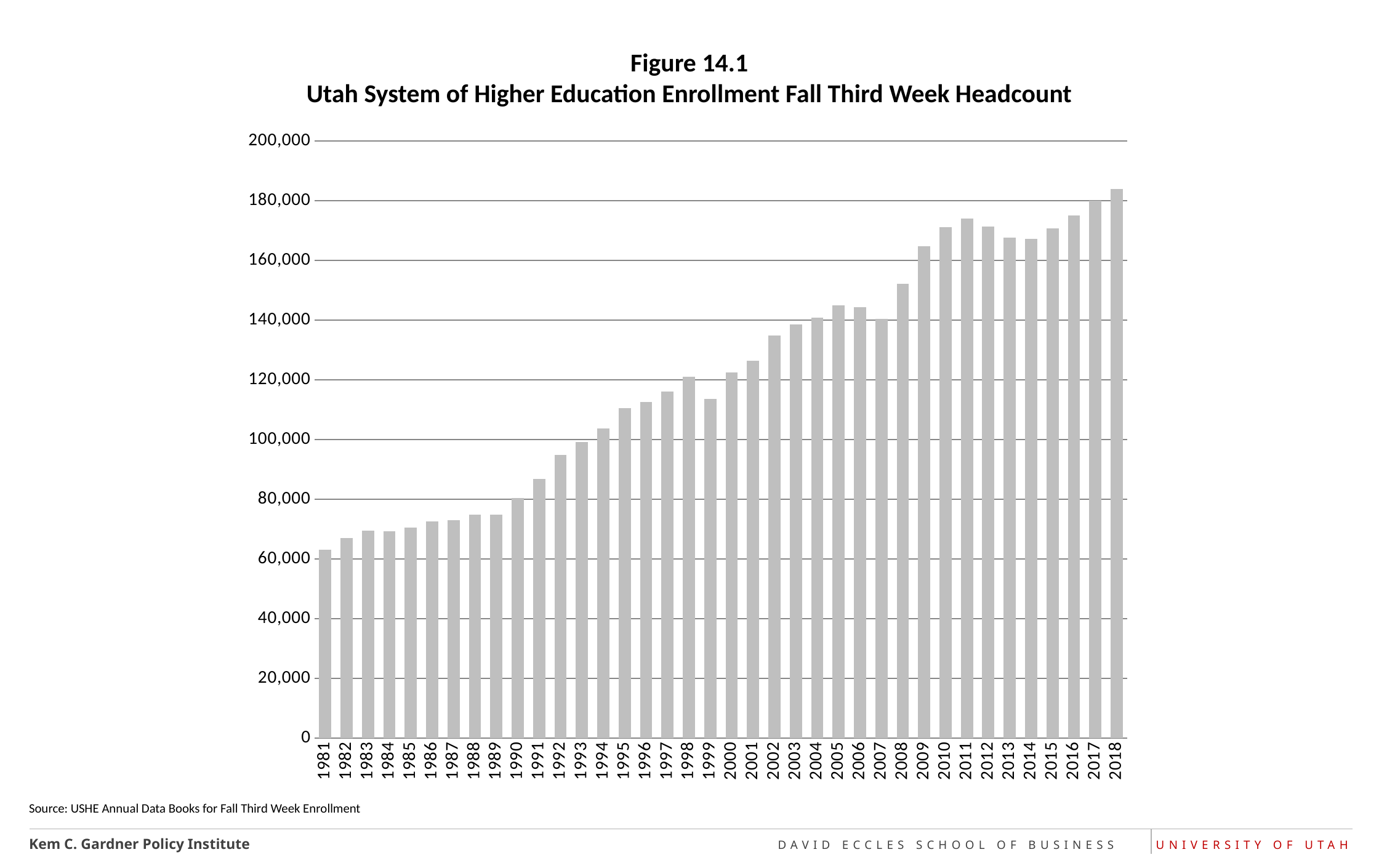
Which year has the highest enrollment headcount? 2018 Overall, do enrollment values rise or fall from 1981 to 2018? rise Is the value for 1992 greater or less than 100,000? less Is the value for 2005 greater or less than 140,000? greater What is the title of the chart? Figure 14.1 Utah System of Higher Education Enrollment Fall Third Week Headcount How many years are plotted on the x axis? 38 Is the value for 2008 greater or less than 160,000? less What kind of chart is shown on the slide? bar chart Which year has the higher enrollment headcount, 1998 or 1999? 1998 Which year has the lowest enrollment headcount? 1981